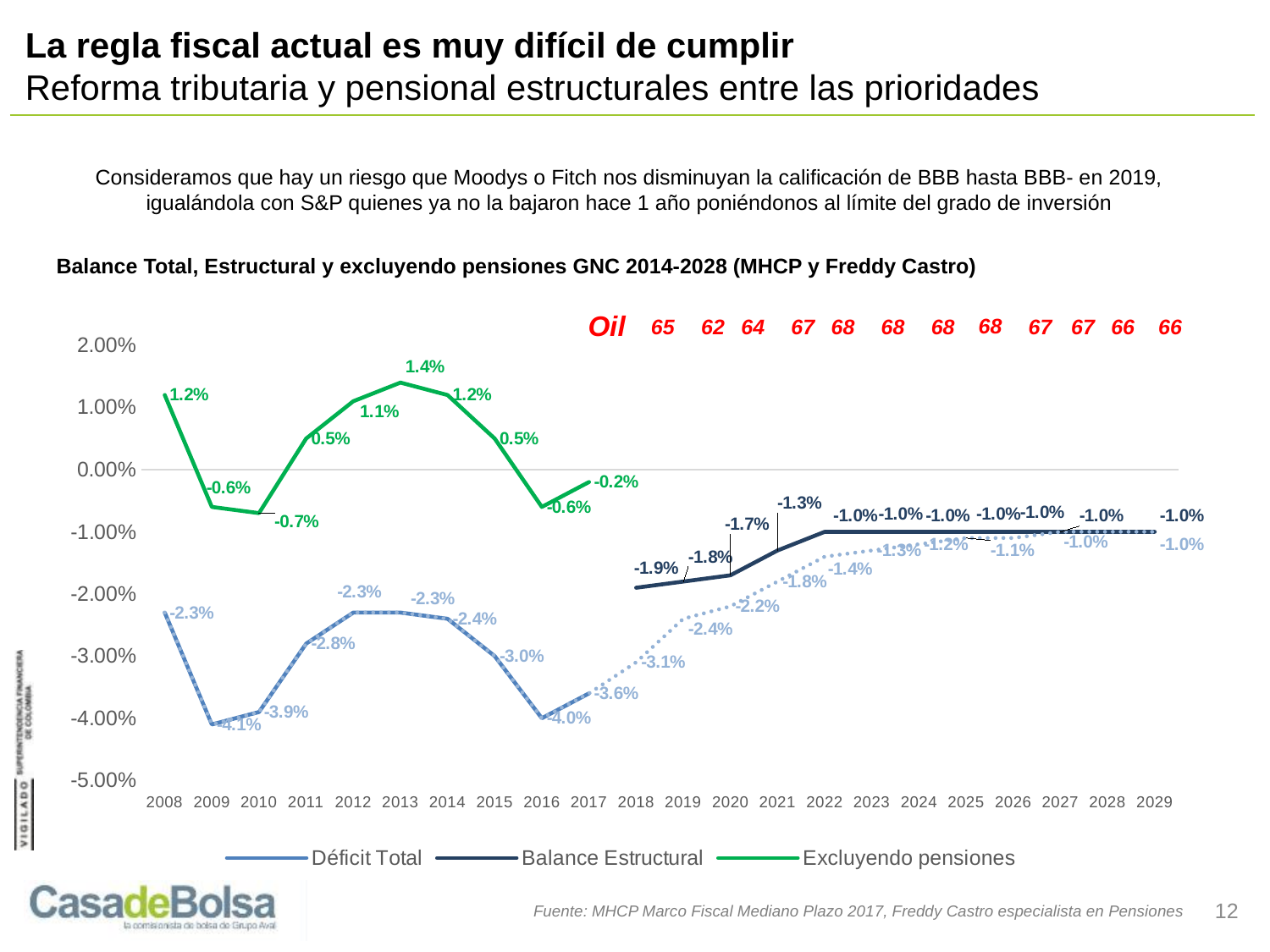
How many years are shown on the x axis of the chart? 22 What is the value of the Déficit Total series in 2016? -4.0% In which year does the Excluyendo pensiones series reach its highest value? 2013 In which year does the Déficit Total series reach its lowest value? 2009 In 2018, which series has the higher value: Déficit Total or Balance Estructural? Balance Estructural By how many percentage points does the Déficit Total change from 2008 (-2.3%) to 2009 (-4.1%)? 1.8 percentage points What is the value of the Balance Estructural series in 2018? -1.9% What kind of chart is shown on the slide? Line chart How many series does the chart legend list? 3 Does the Déficit Total series rise or fall between 2016 and 2022? Rise What is the value of the Excluyendo pensiones series in 2010? -0.7% What is the value of the Excluyendo pensiones series in 2013? 1.4%